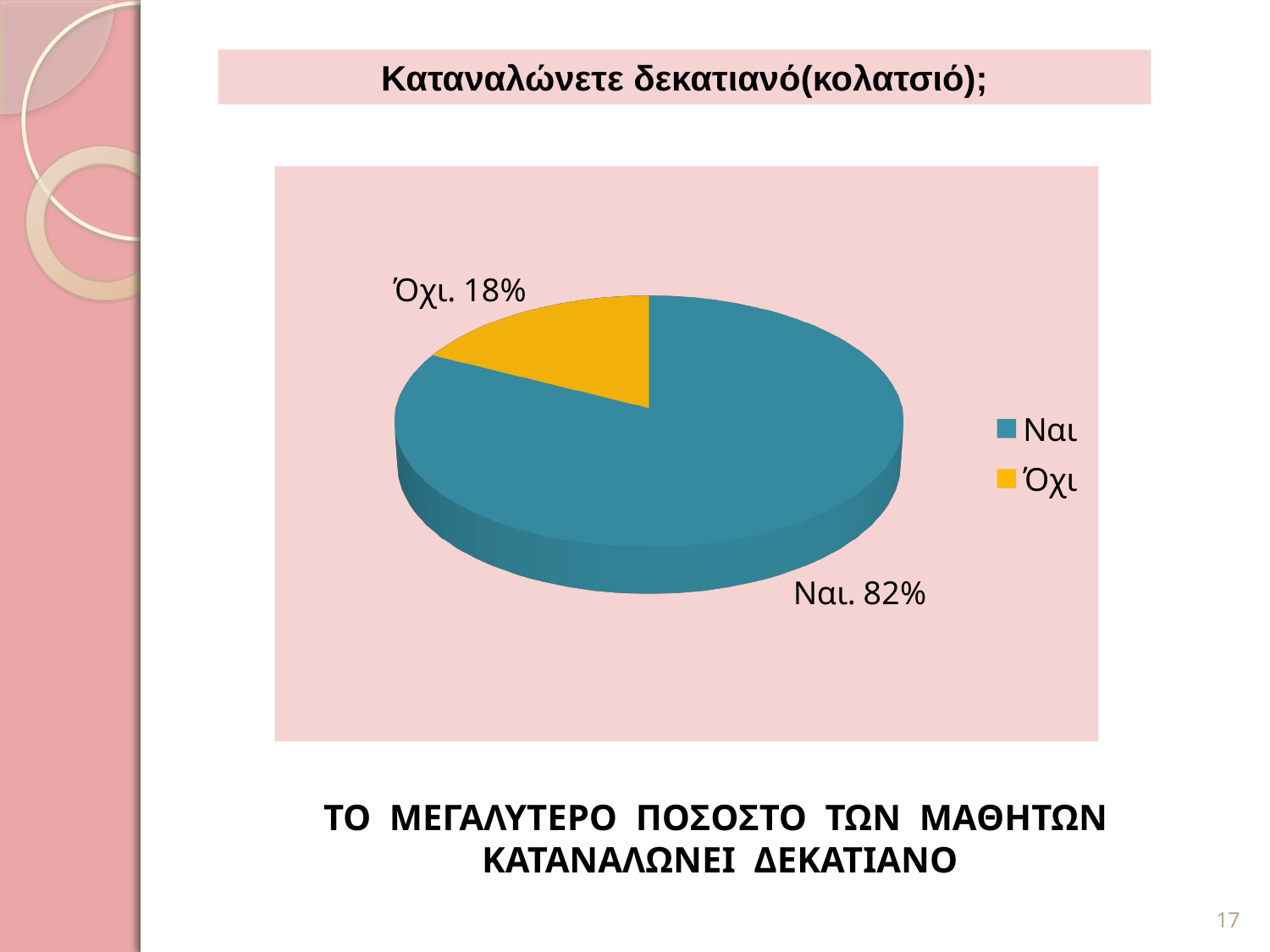
What percentage of the pie is labelled Όχι? 18% How many slices does the pie chart have? 2 What is the difference in percentage points between the Ναι and Όχι slices? 64 What share of the pie does the Όχι slice take? 18% Which is larger, the Ναι slice or the Όχι slice? Ναι What colour is the Ναι slice? teal blue Which slice of the pie is the largest? Ναι What is the title shown above the chart? Καταναλώνετε δεκατιανό(κολατσιό); What percentage of the pie is labelled Ναι? 82% Which slice of the pie is the smallest? Όχι How many entries does the legend list? 2 What kind of chart is shown on the slide? pie chart